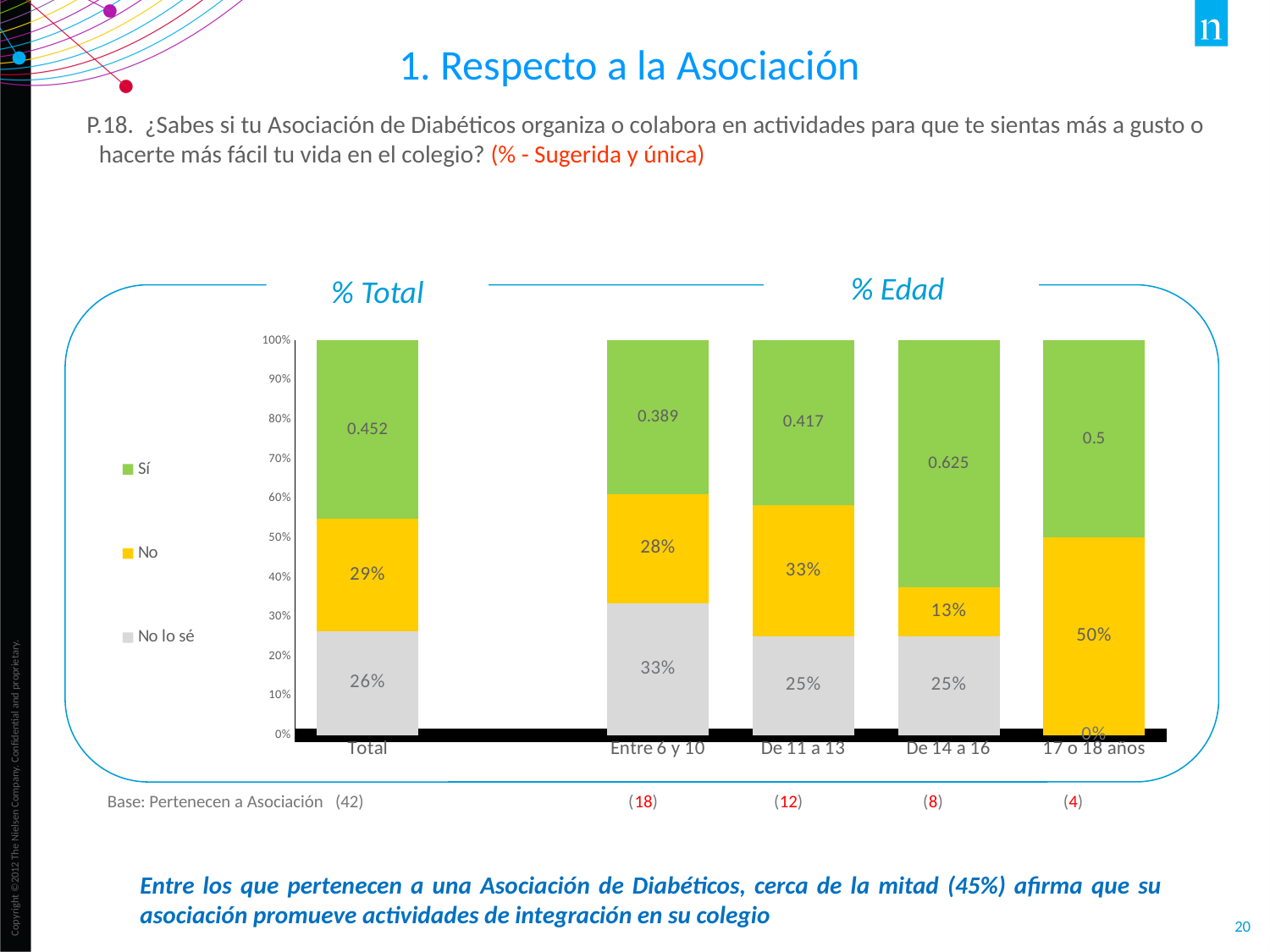
What is the value for "No" in the "De 11 a 13" bar? 33% What kind of chart is shown on the slide? stacked bar chart Which is larger, the "No" value for "De 14 a 16" or the "No" value for "17 o 18 años"? 17 o 18 años How many categories are shown along the x axis? 5 How many series does the legend list? 3 What is the difference between the "No" value for "17 o 18 años" and the "No" value for "De 14 a 16"? 37% What is the value for "No lo sé" in the "Entre 6 y 10" bar? 33% What is the value labelled for "Sí" in the "De 14 a 16" bar? 0.625 Which age category has the highest "Sí" value? De 14 a 16 What is the value labelled for "Sí" in the "Total" bar? 0.452 What is the value for "No" in the "17 o 18 años" bar? 50% Which category has the lowest "No lo sé" value? 17 o 18 años